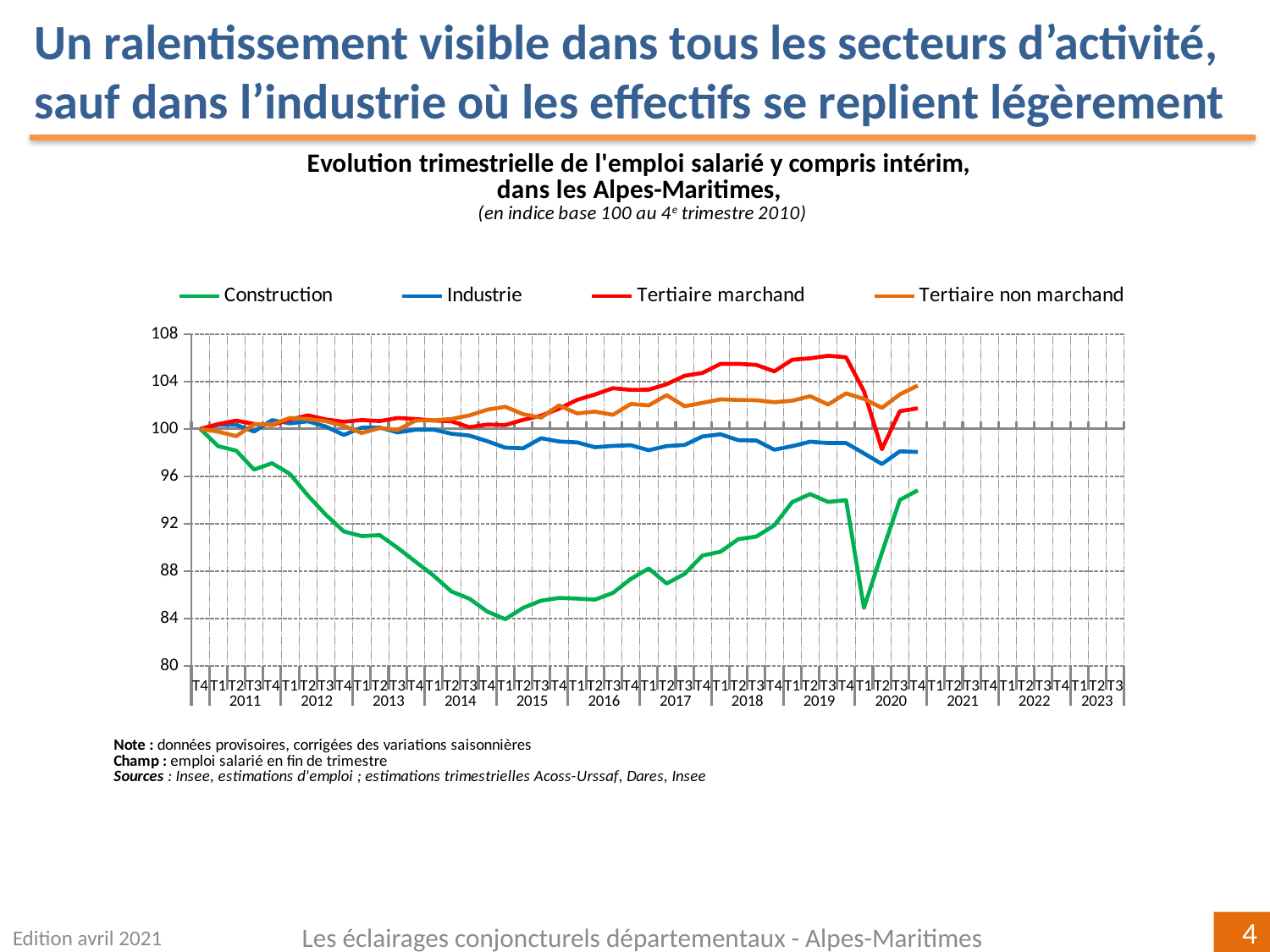
Is the value for Tertiaire non marchand at T4 2020 greater or less than 100? greater Which series is shown in green in the legend? Construction Is the value for Industrie at T1 2020 greater or less than 100? less At T4 2020, which is larger: Tertiaire marchand or Tertiaire non marchand? Tertiaire non marchand What kind of chart is shown on the slide? line chart Which series has the lowest value at T4 2020? Construction How many series does the legend list? 4 Does the Construction series rise or fall between T4 2010 and T4 2014? fall Is the value for Tertiaire marchand at T4 2019 greater or less than 104? greater What is the base period of the index used on the y axis, according to the chart subtitle? 4e trimestre 2010 Which series has the highest value at T4 2019? Tertiaire marchand